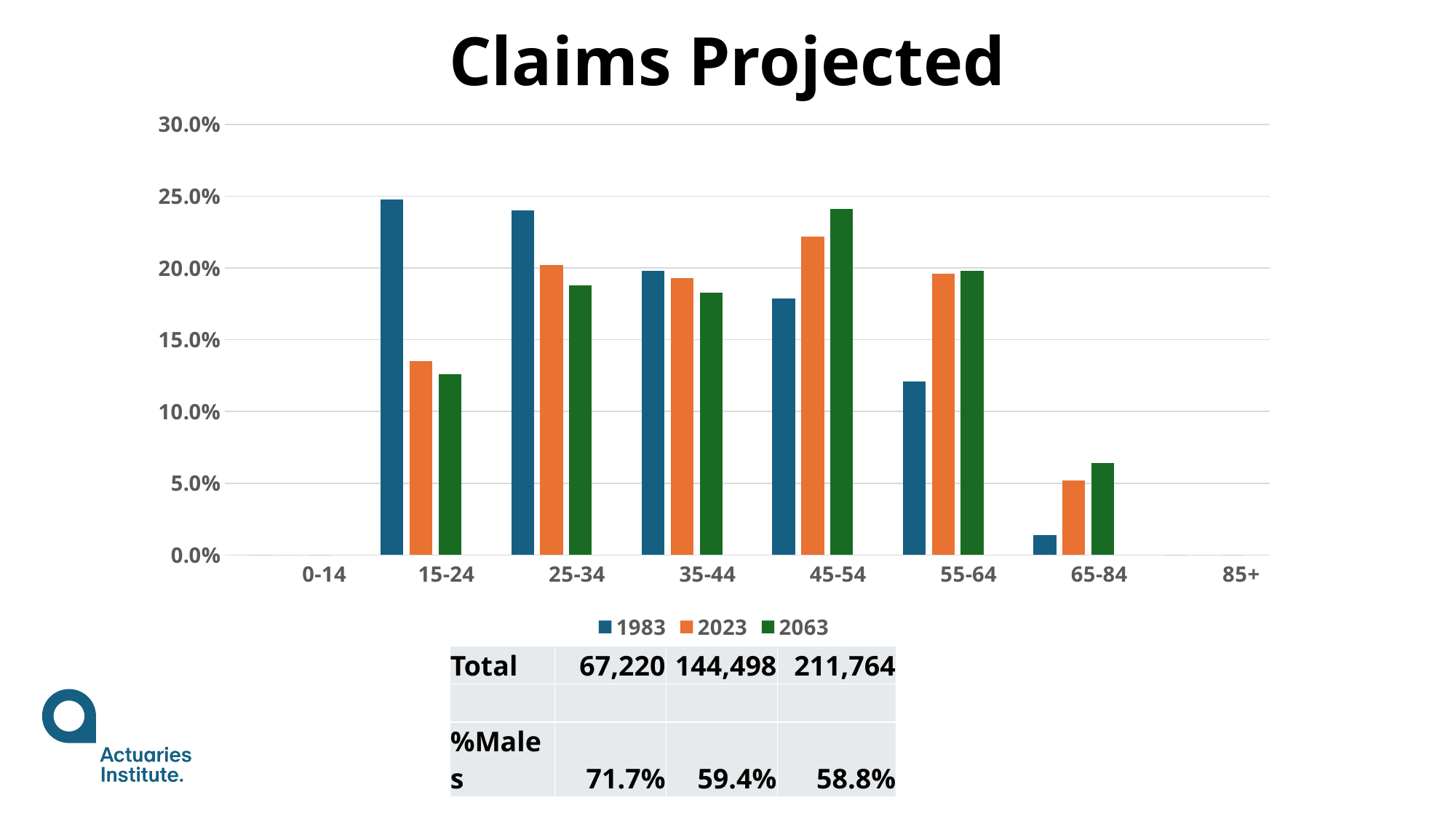
What kind of chart is shown on the slide? bar chart In the 45-54 age group, which series has the larger value, 1983 or 2063? 2063 Which age group has the highest value for the 2023 series? 45-54 How many age-group categories are shown on the x axis? 8 What is the title of the chart? Claims Projected Is the value for 2023 in the 15-24 age group greater or less than 15.0%? less Which age group has the highest value for the 2063 series? 45-54 How many series does the legend list? 3 In the 15-24 age group, which series has the larger value, 1983 or 2023? 1983 Is the value for 1983 in the 65-84 age group greater or less than 5.0%? less Is the value for 1983 in the 15-24 age group greater or less than 20.0%? greater Do the values for the 1983 series rise or fall from the 15-24 age group to the 65-84 age group? fall